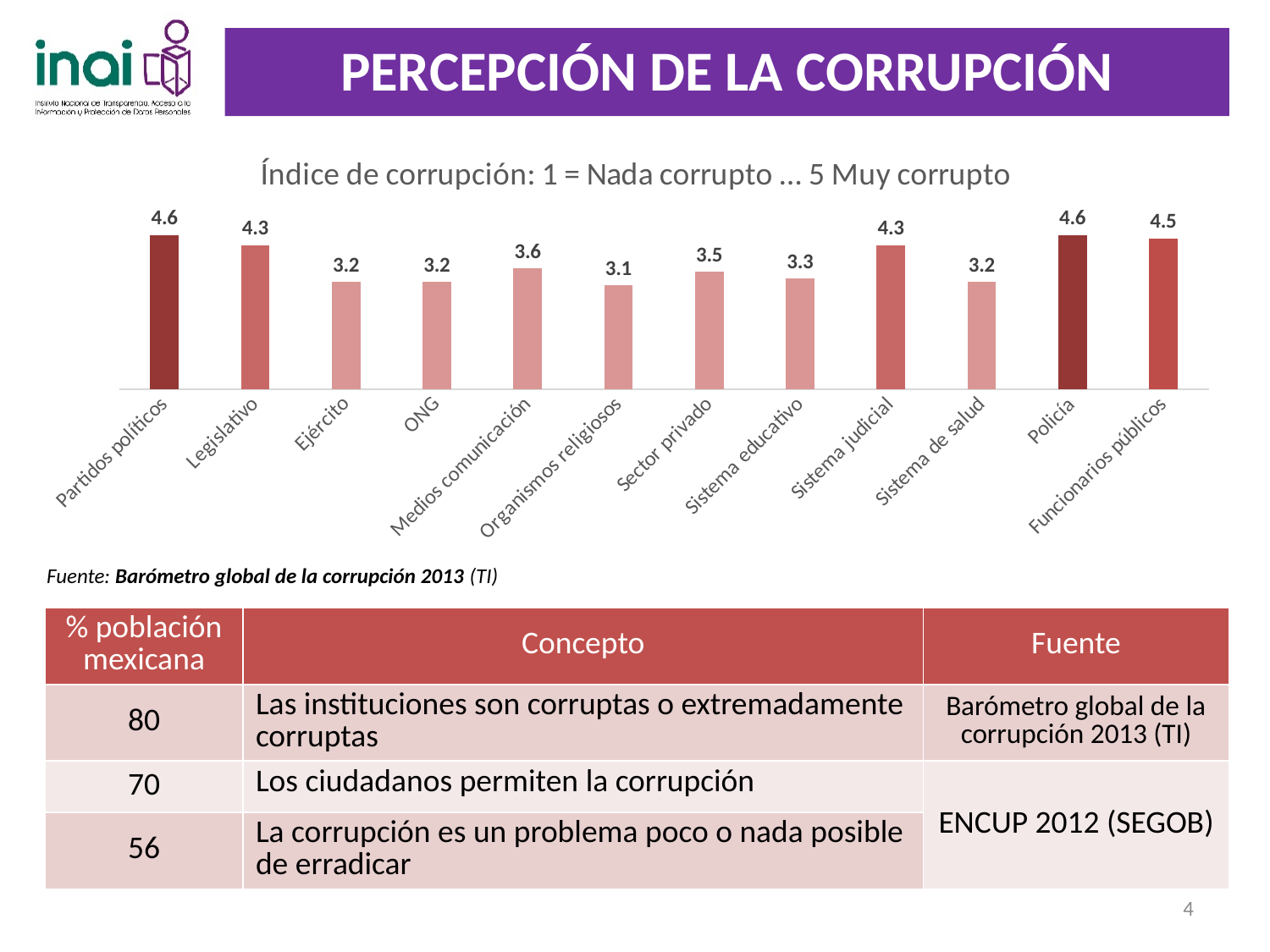
Which has a higher corruption index value, Sistema educativo or Sector privado? Sector privado What is the corruption index value for Funcionarios públicos? 4.5 What is the difference between the corruption index values for Policía and Sistema de salud? 1.4 What is the corruption index value for Partidos políticos? 4.6 Which category has the lowest corruption index value? Organismos religiosos What type of chart is shown on the slide? Bar chart What is the corruption index value for Sistema judicial? 4.3 What is the corruption index value for Sector privado? 3.5 What is the corruption index value for Medios comunicación? 3.6 What is the difference between the corruption index values for Legislativo and Ejército? 1.1 Which has a higher corruption index value, Funcionarios públicos or Sistema judicial? Funcionarios públicos How many categories are shown in the chart? 12